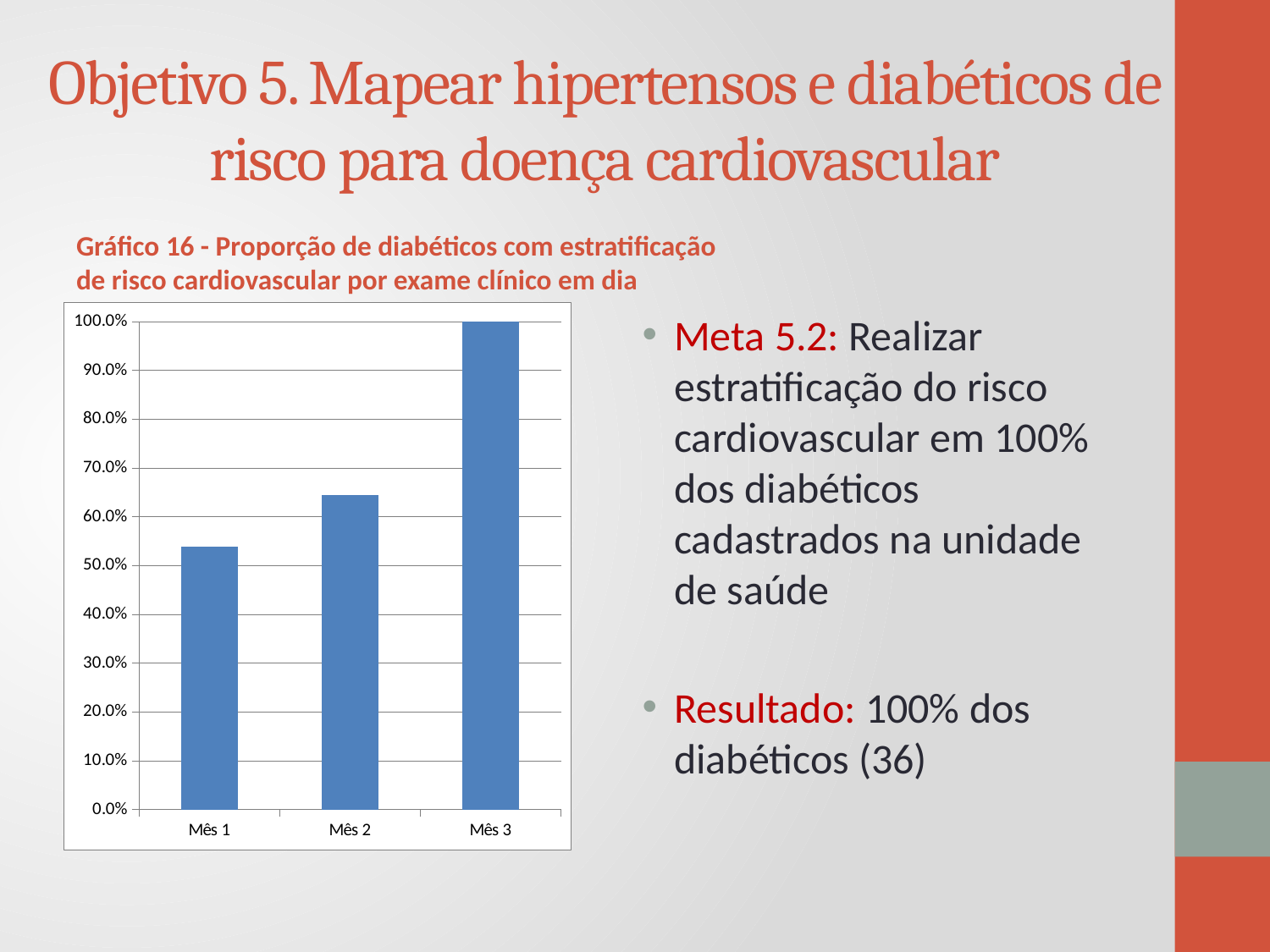
Do the values rise or fall from Mês 1 to Mês 3? rise Which month has the highest value on the chart? Mês 3 What kind of chart is shown on the slide? bar chart Is the value for Mês 1 greater or less than 60.0%? less What is the title of the chart? Gráfico 16 - Proporção de diabéticos com estratificação de risco cardiovascular por exame clínico em dia Which is larger, the value for Mês 1 or the value for Mês 2? Mês 2 Which month has the lowest value on the chart? Mês 1 Is the value for Mês 1 greater or less than 50.0%? greater Is the value for Mês 2 greater or less than 60.0%? greater What is the value for Mês 3? 100.0% How many categories (months) are plotted on the chart? 3